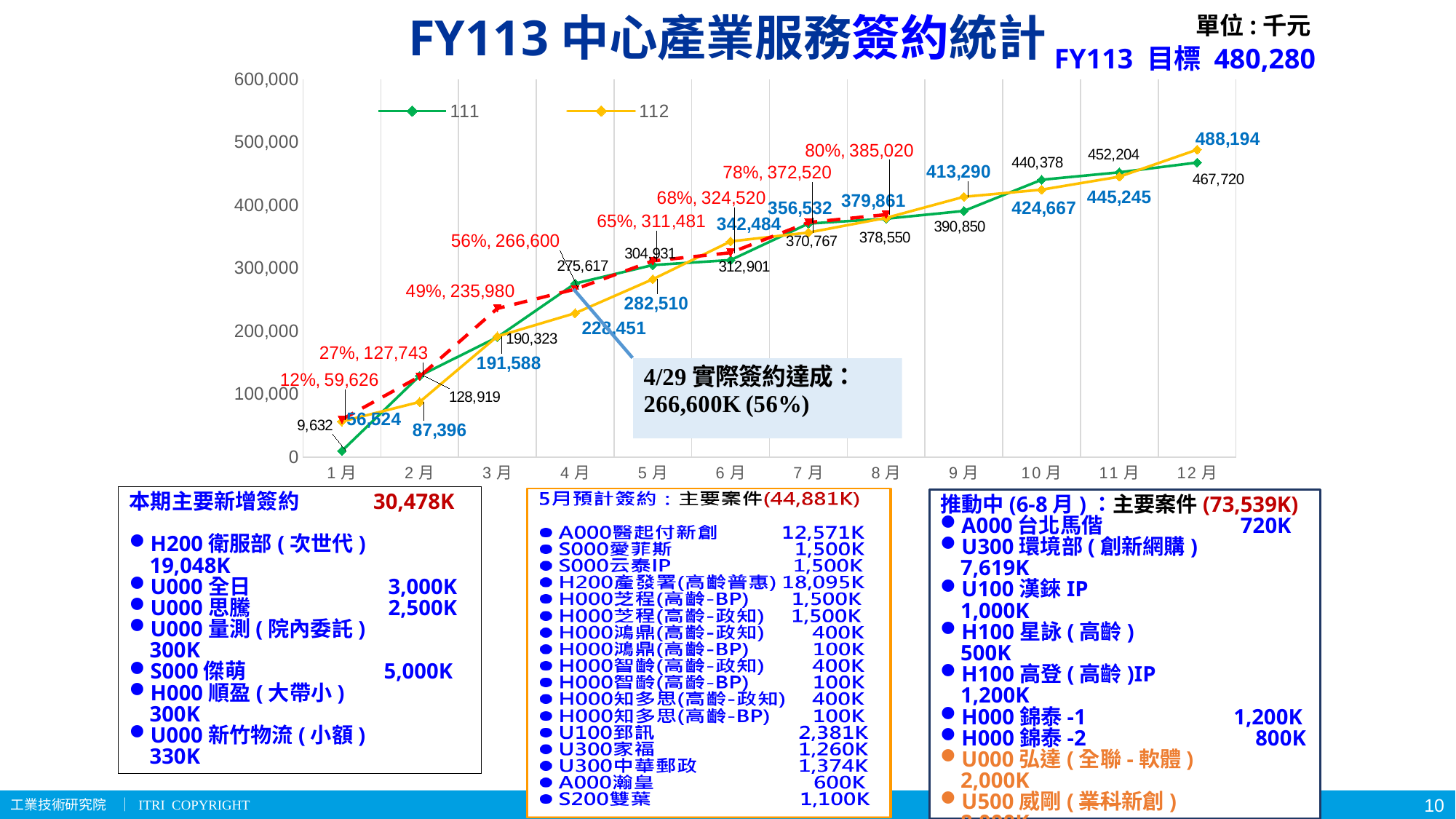
What kind of chart is shown on the slide? line chart What is the value of the 111 series at 4月? 275,617 In which month is the 111 series at its lowest value? 1月 How many series does the chart legend list? 2 What is the value of the 111 series at 12月? 467,720 How many months are plotted along the x axis? 12 What is the value of the 112 series at 1月? 56,524 In which month does the 112 series reach its highest value? 12月 What is the difference between the 112 and 111 series values at 12月? 20,474 What is the value of the 112 series at 12月? 488,194 At 4月, which series has the larger value, 111 or 112? 111 What is the FY113 target shown at the top right of the slide? 480,280